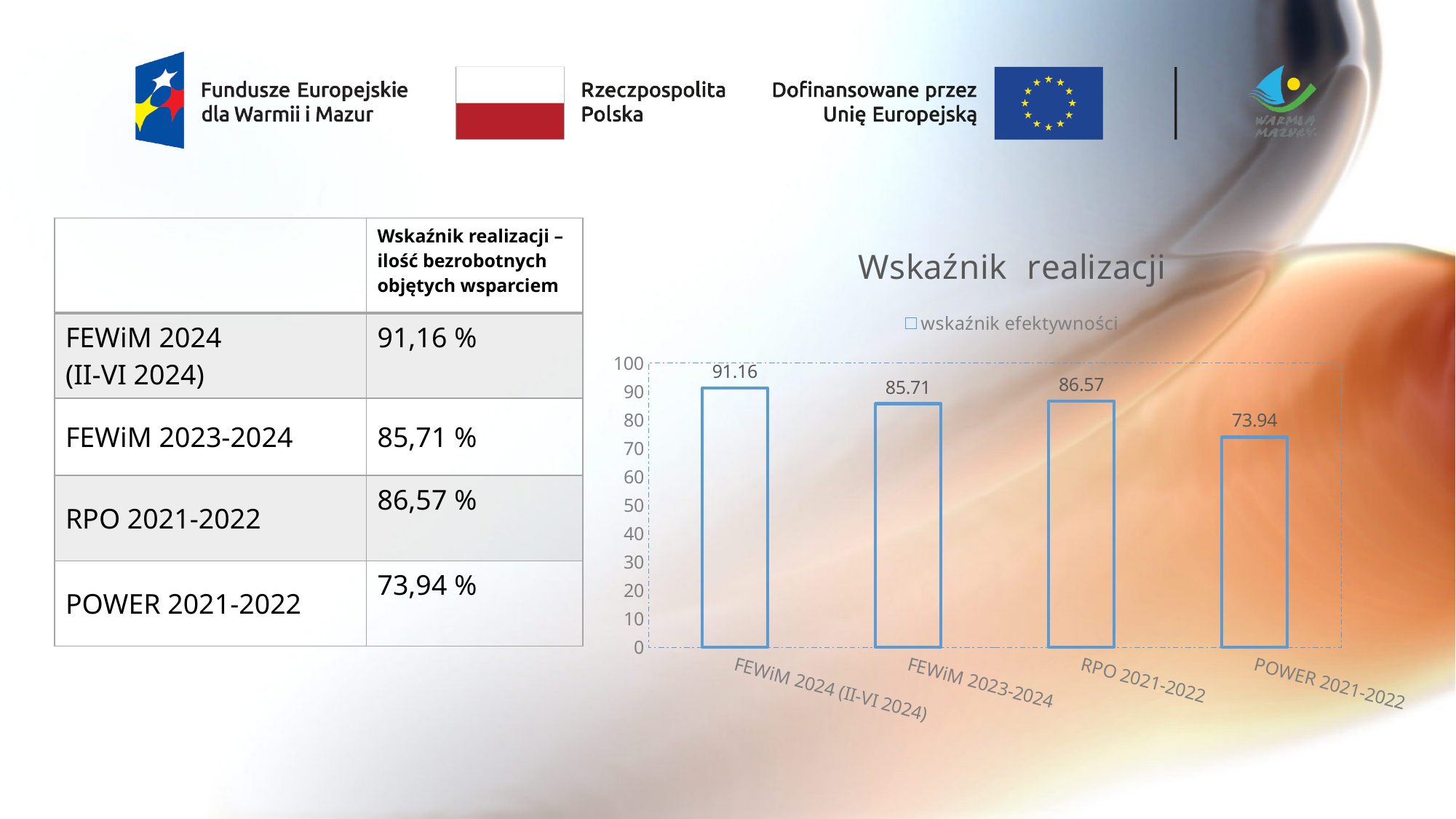
What is the value for POWER 2021-2022 in the chart? 73.94 How many categories are shown in the chart? 4 What is the value for FEWiM 2024 (II-VI 2024) in the chart? 91.16 Which category has the highest value in the chart? FEWiM 2024 (II-VI 2024) Which category has the lowest value in the chart? POWER 2021-2022 What kind of chart is shown on the slide? bar chart What is the title of the chart? Wskaźnik realizacji Is the value for POWER 2021-2022 greater or less than 80? less Which is larger: the value for FEWiM 2023-2024 or the value for POWER 2021-2022? FEWiM 2023-2024 What is the value for RPO 2021-2022 in the chart? 86.57 What is the difference between the values for RPO 2021-2022 and FEWiM 2023-2024? 0.86 What is the difference between the values for FEWiM 2024 (II-VI 2024) and POWER 2021-2022? 17.22